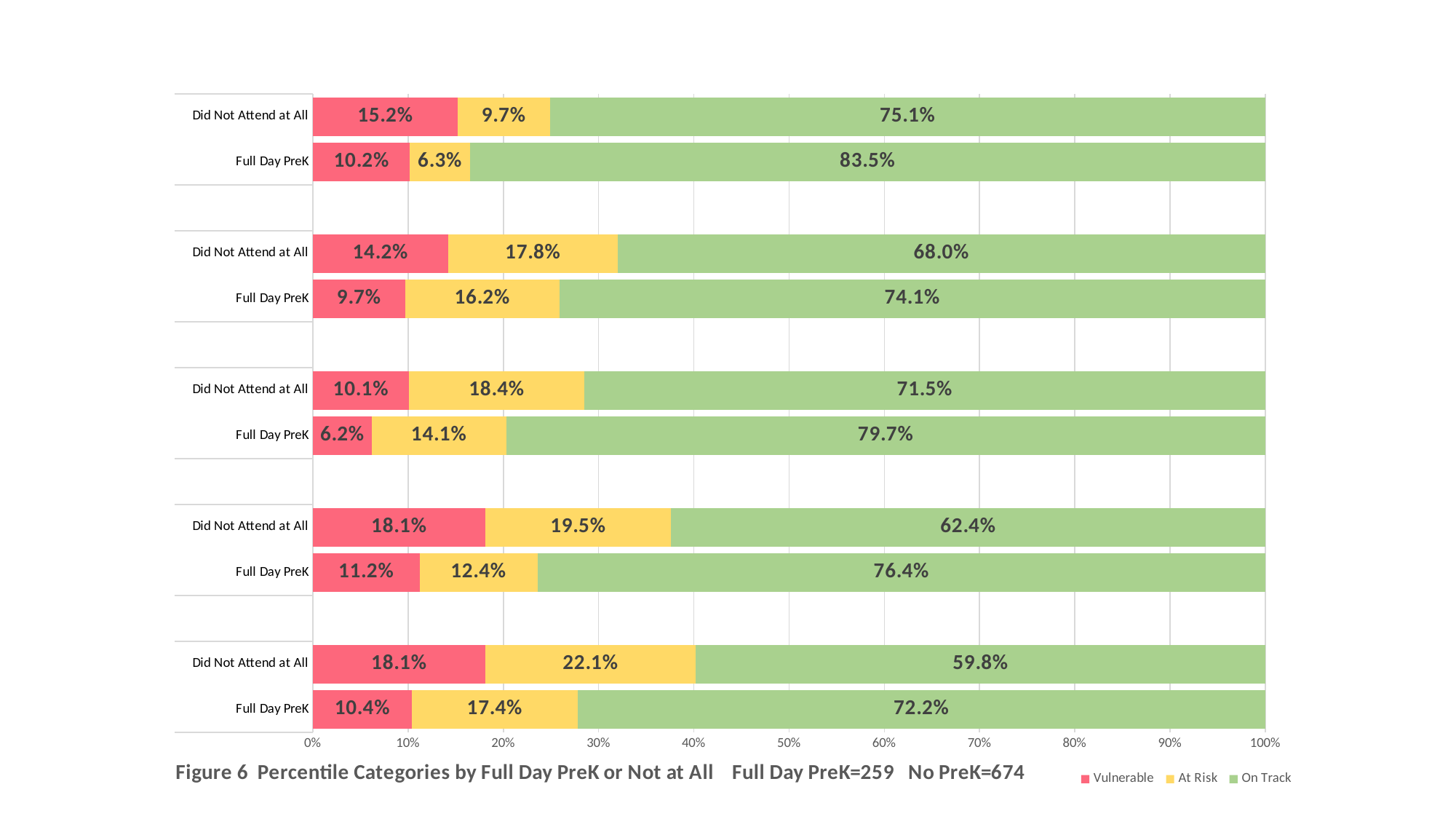
Which bar has the lowest On Track value on the chart? Did Not Attend at All in the bottom pair (59.8%) In the top pair of bars, what is the On Track value for Full Day PreK? 83.5% Which bar has the highest On Track value on the chart? Full Day PreK in the top pair (83.5%) In the second pair of bars from the top, which has the larger At Risk value: Did Not Attend at All or Full Day PreK? Did Not Attend at All In the fourth pair of bars from the top, what is the difference between the Vulnerable values for Did Not Attend at All and Full Day PreK? 6.9 percentage points How many bars are plotted on the chart? 10 How many series does the legend list? 3 In the bottom pair of bars, what is the Vulnerable value for Did Not Attend at All? 18.1% What is the title of the chart? Figure 6 Percentile Categories by Full Day PreK or Not at All Full Day PreK=259 No PreK=674 In the bottom pair of bars, what is the difference between the On Track values for Full Day PreK and Did Not Attend at All? 12.4 percentage points What kind of chart is shown on the slide? Stacked bar chart In the third pair of bars from the top, what is the At Risk value for Full Day PreK? 14.1%